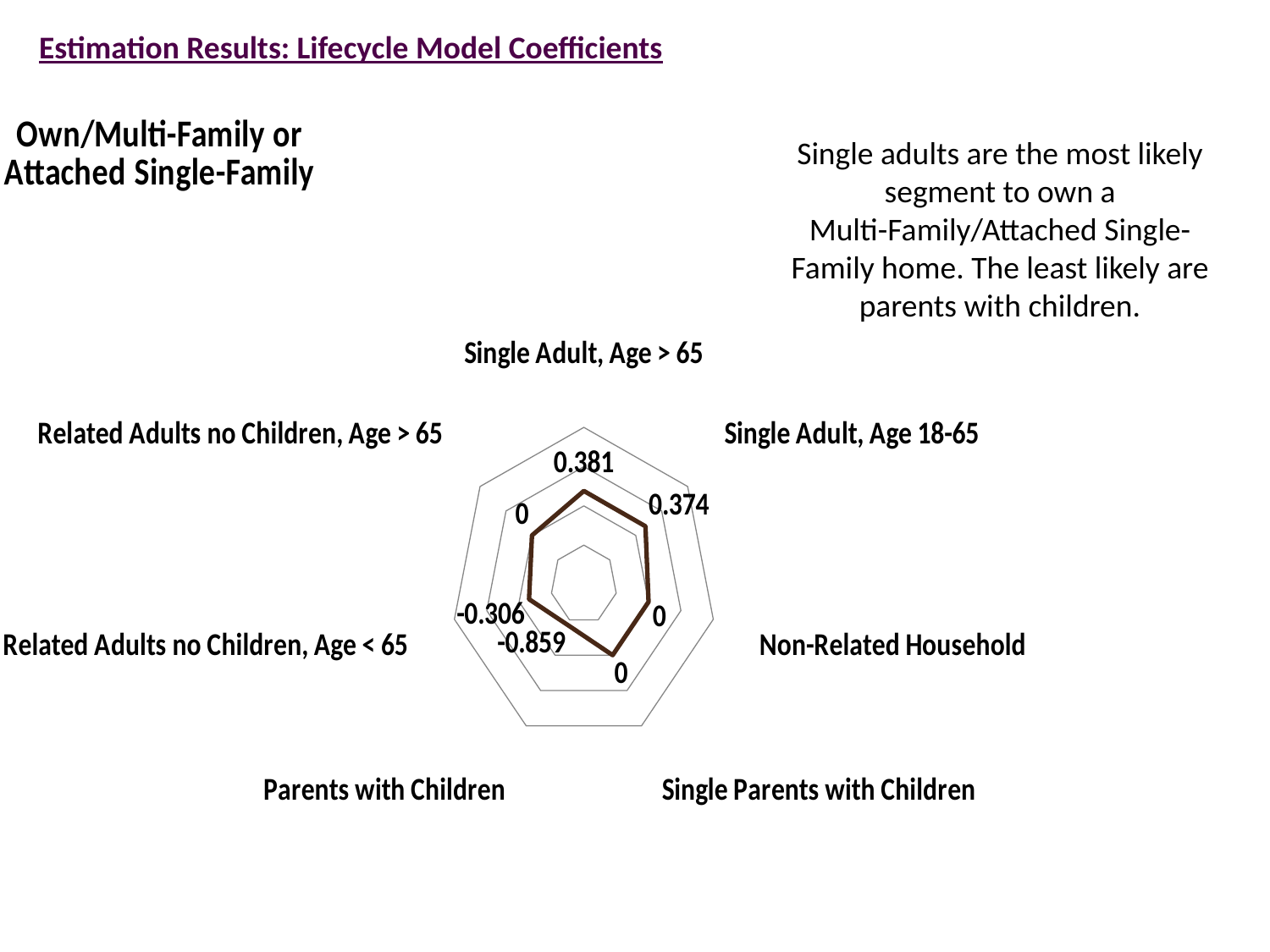
What type of chart is shown on the slide? Radar chart What is the coefficient for Related Adults no Children, Age < 65? -0.306 What is the difference between the coefficients for Single Adult, Age > 65 and Single Adult, Age 18-65? 0.007 What is the coefficient for Non-Related Household? 0 What is the coefficient for Parents with Children? -0.859 Which is larger, the coefficient for Related Adults no Children, Age < 65 or for Parents with Children? Related Adults no Children, Age < 65 What is the coefficient for Single Adult, Age > 65? 0.381 What is the title of the chart? Own/Multi-Family or Attached Single-Family Which category has the lowest coefficient? Parents with Children Which category has the highest coefficient? Single Adult, Age > 65 What is the coefficient for Single Adult, Age 18-65? 0.374 How many categories are plotted on the radar chart? 7